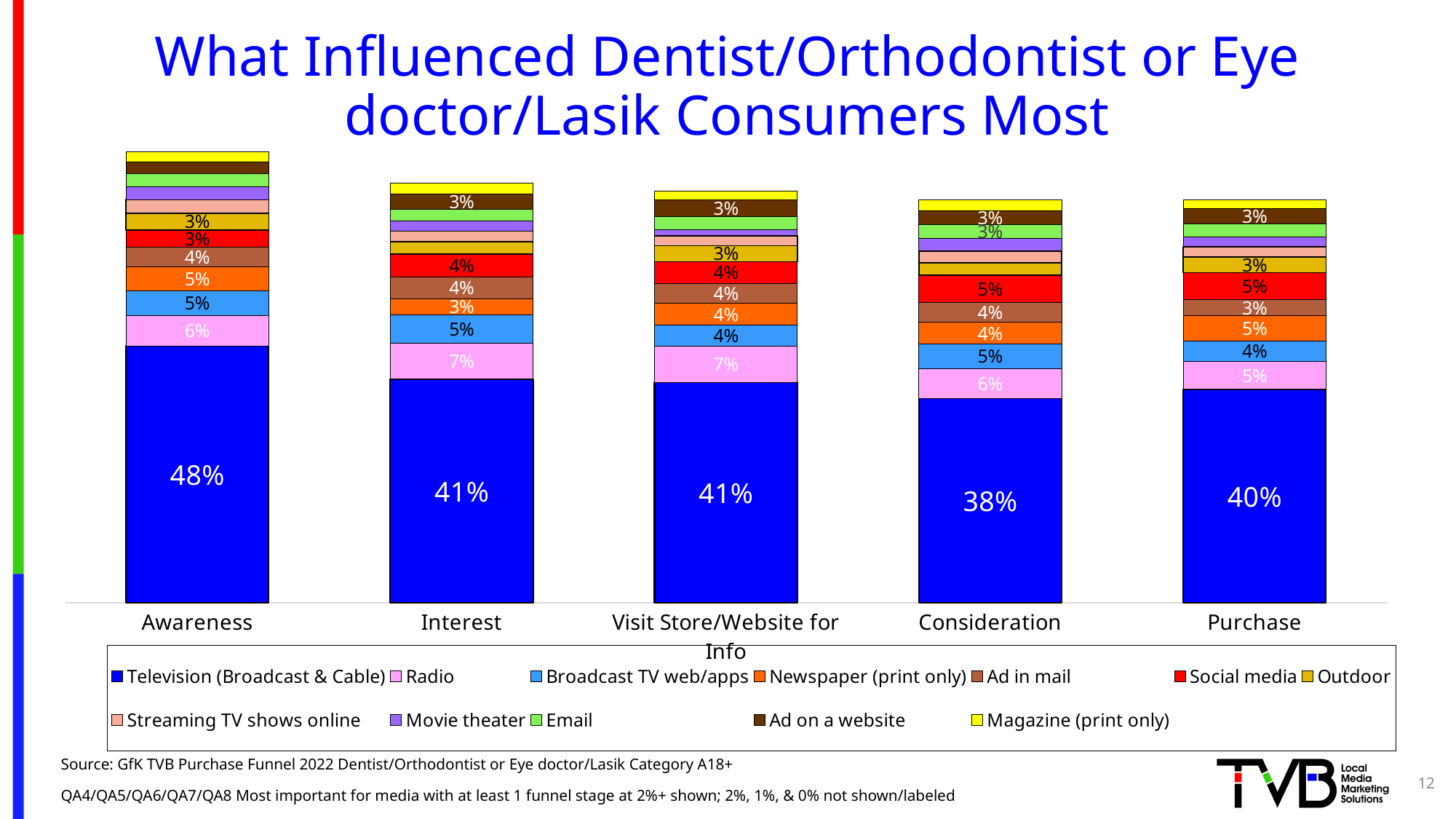
What is the Radio value for the Interest stage? 7% What is the difference between the Television (Broadcast & Cable) values for Awareness and Consideration? 10 percentage points What is the Social media value for the Consideration stage? 5% Which funnel stage has the highest Television (Broadcast & Cable) value? Awareness What type of chart is shown on the slide? Stacked bar chart Which is larger: the Radio value for Interest or the Radio value for Purchase? Interest How many funnel stages are shown along the x axis? 5 How many media series does the legend list? 12 What percentage of Awareness is attributed to Television (Broadcast & Cable)? 48% What is the Newspaper (print only) value for the Purchase stage? 5% Which funnel stage has the lowest Television (Broadcast & Cable) value? Consideration Which colour represents Television (Broadcast & Cable) in the chart? Blue